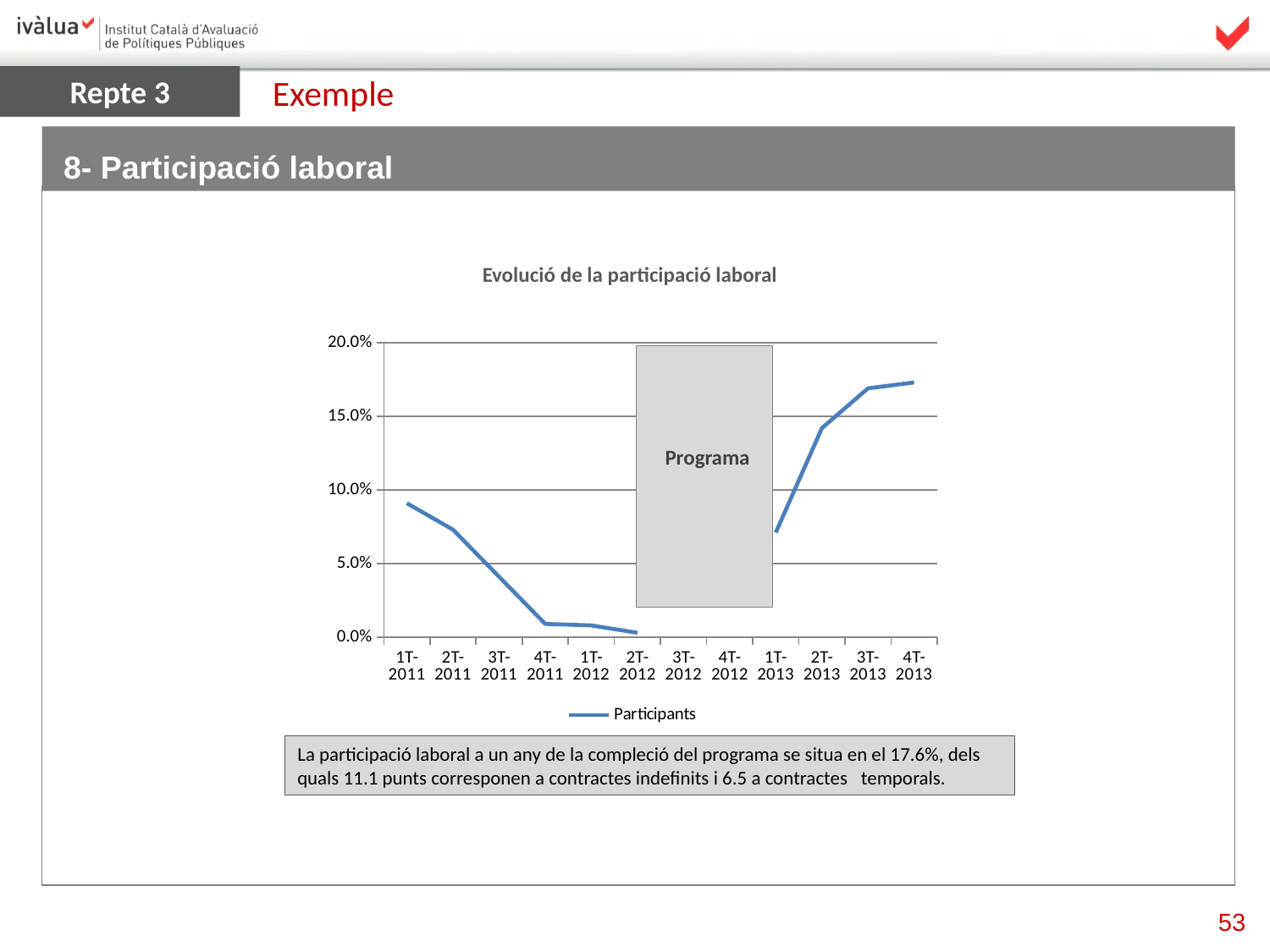
Do the values rise or fall from 1T-2013 to 4T-2013? rise What is the title of the chart? Evolució de la participació laboral How many series does the chart legend list? 1 Do the values rise or fall from 1T-2011 to 2T-2012? fall Is the value for 4T-2011 greater or less than 5.0%? less What is the name of the series shown in the legend? Participants Is the value for 1T-2011 greater or less than 5.0%? greater What kind of chart is shown on the slide? line chart Which has the larger value, 1T-2011 or 2T-2012? 1T-2011 Is the value for 1T-2013 greater or less than 10.0%? less How many quarters are labelled on the x axis of the chart? 12